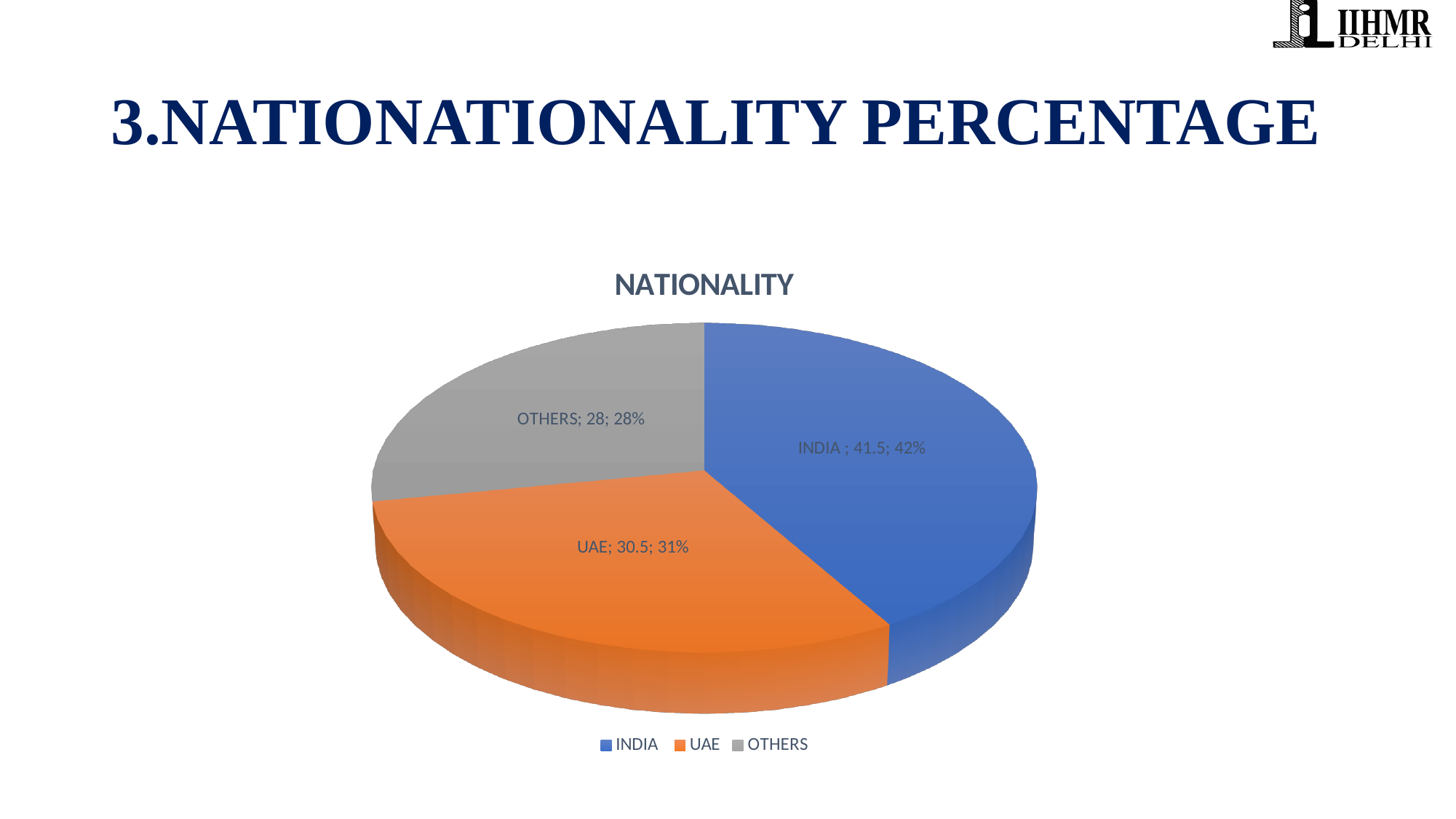
What share of the pie does INDIA represent? 42% What is the value for OTHERS? 28 How many entries does the legend list? 3 What is the difference between the values for INDIA and UAE? 11 What is the value for UAE? 30.5 What is the value for INDIA? 41.5 What is the title of the chart? NATIONALITY Which category has the smallest slice? OTHERS Which category has the largest slice? INDIA What share of the pie does UAE represent? 31% What kind of chart is shown on the slide? pie chart How many slices does the pie chart have? 3